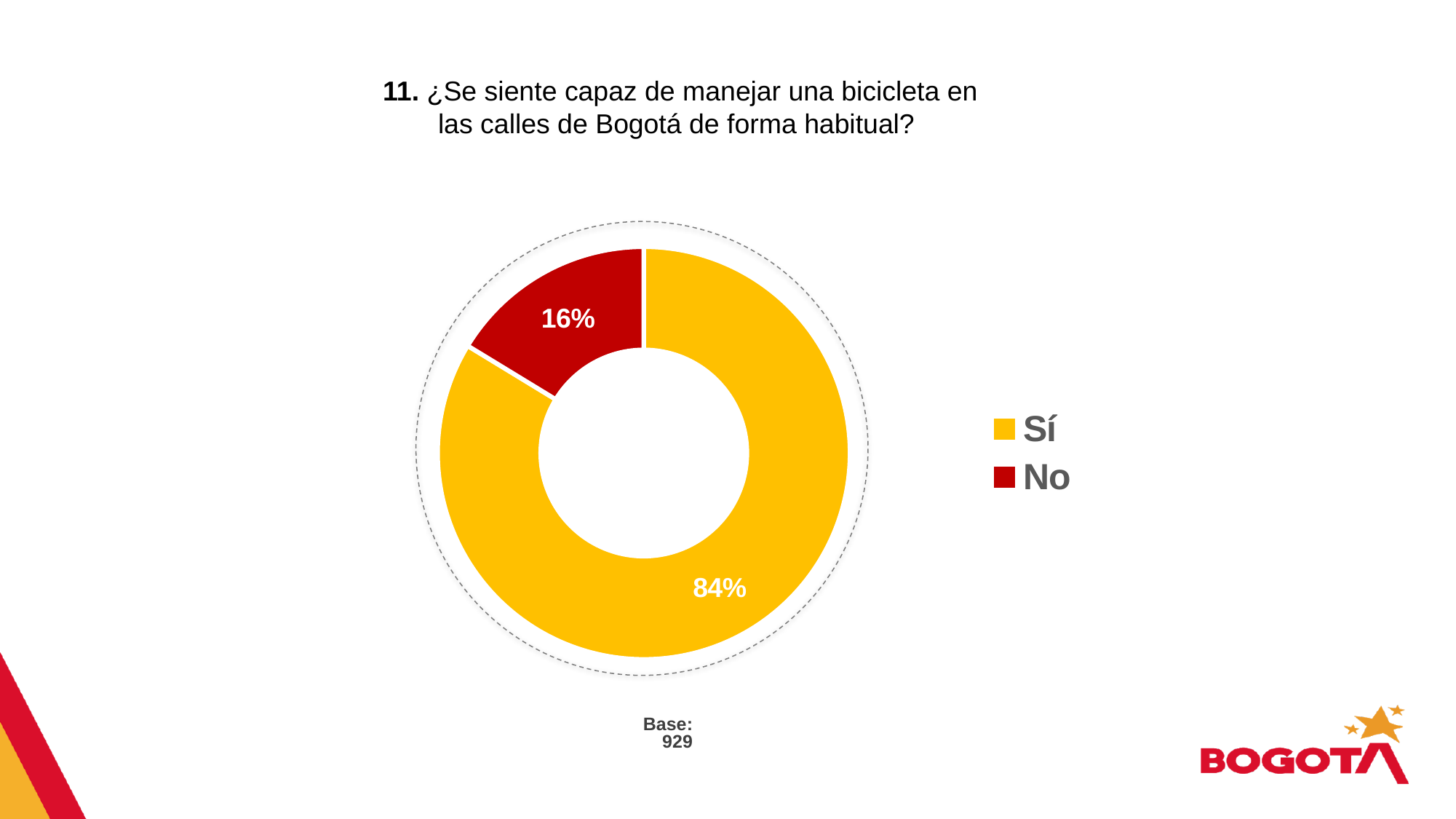
What percentage of respondents answered "Sí"? 84% What kind of chart is shown on the slide? Pie chart (donut) What colour represents the "No" category in the chart? Red What share of the pie does the "No" slice represent? 16% What is the difference in percentage points between the "Sí" and "No" shares? 68 Which response has the smallest share of the chart? No Which is larger, the share for "Sí" or the share for "No"? Sí What percentage of respondents answered "No"? 16% Which response has the largest share of the chart? Sí How many categories does the chart show? 2 What is the base (number of respondents) shown below the chart? 929